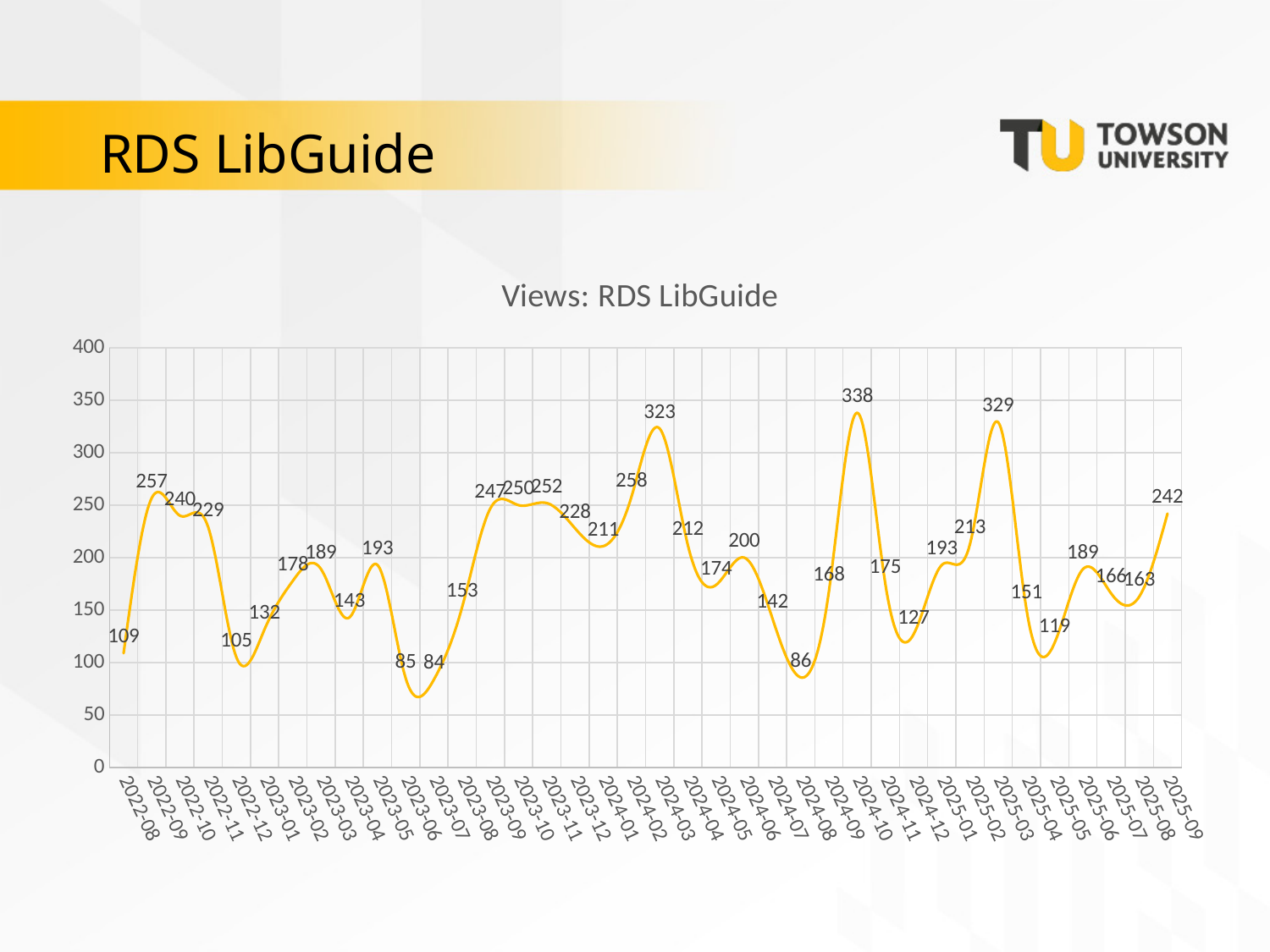
Which is larger, the value for 2023-04 or the value for 2023-05? 2023-05 What is the title of the chart? Views: RDS LibGuide Which month has the highest value in the Views: RDS LibGuide chart? 2024-10 Do the values rise or fall from 2024-10 to 2024-12? fall What is the value for 2024-03 in the Views: RDS LibGuide chart? 323 What is the difference between the values for 2024-10 and 2025-03? 9 How many monthly data points are plotted in the chart? 38 What kind of chart is shown on the slide? line chart What is the value for 2025-09? 242 What is the difference between the values for 2025-09 and 2025-08? 79 Which month has the lowest value in the Views: RDS LibGuide chart? 2023-07 What is the value for 2023-06? 85